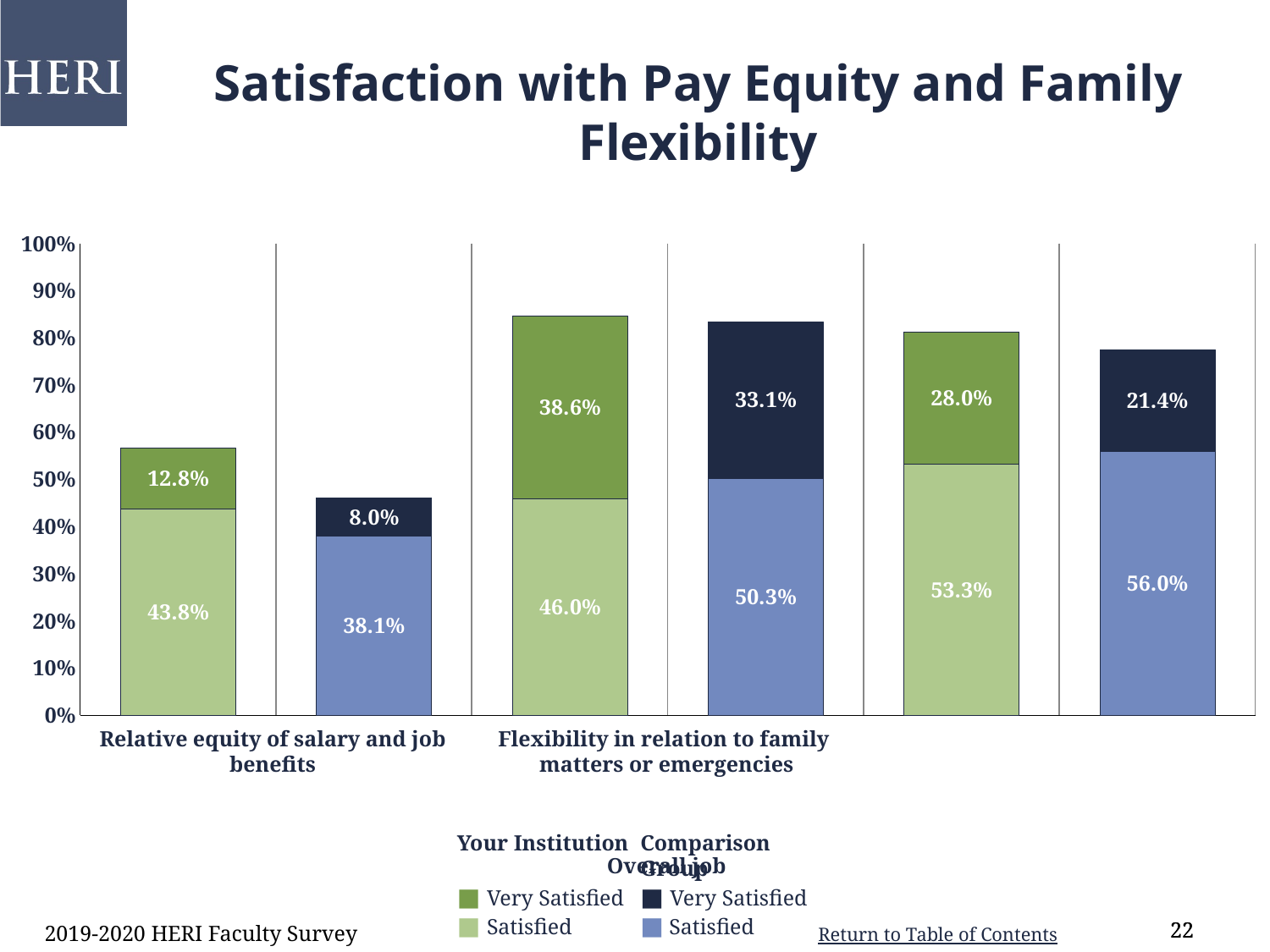
What kind of chart is shown on the slide? Stacked bar chart What percentage of Comparison Group respondents are Satisfied with flexibility in relation to family matters or emergencies? 50.3% What is the combined Satisfied plus Very Satisfied percentage for the Comparison Group on flexibility in relation to family matters or emergencies? 83.4% What is the difference between the Your Institution and Comparison Group Very Satisfied percentages for relative equity of salary and job benefits? 4.8% Is the Comparison Group's Satisfied value for relative equity of salary and job benefits greater or less than 40%? less What percentage of Comparison Group respondents are Very Satisfied with relative equity of salary and job benefits? 8.0% What is the combined Satisfied plus Very Satisfied percentage for Your Institution on relative equity of salary and job benefits? 56.6% How many entries does the legend list? 4 What percentage of Your Institution respondents are Satisfied with relative equity of salary and job benefits? 43.8% For flexibility in relation to family matters or emergencies, which group has the larger Satisfied percentage, Your Institution or the Comparison Group? Comparison Group What is the title of the chart? Satisfaction with Pay Equity and Family Flexibility What percentage of Your Institution respondents are Very Satisfied with flexibility in relation to family matters or emergencies? 38.6%